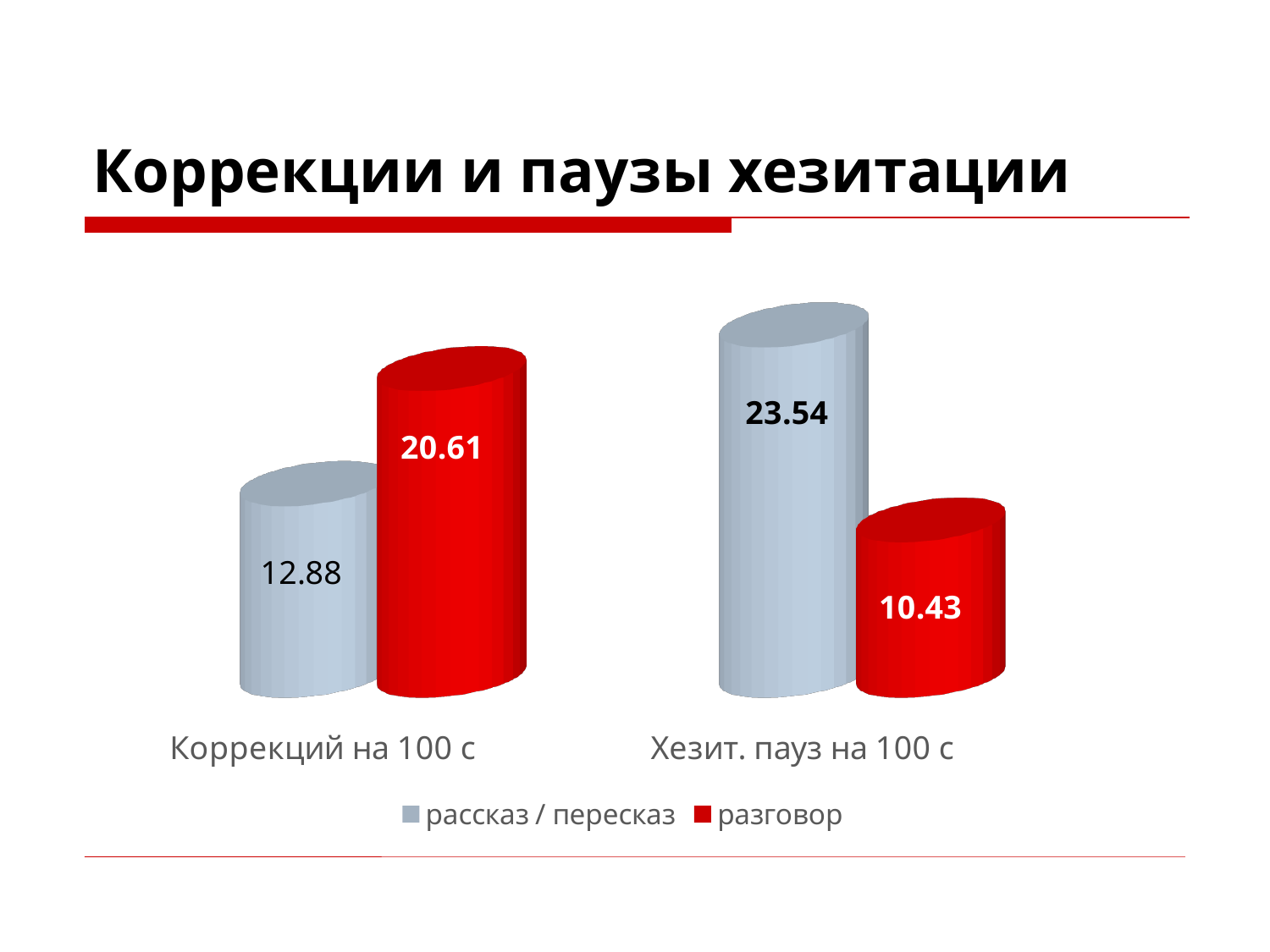
What is the difference between the рассказ / пересказ and разговор values in the Хезит. пауз на 100 с category? 13.11 Which bar has the highest value on the chart? рассказ / пересказ, Хезит. пауз на 100 с (23.54) What type of chart is shown on the slide? Bar chart How many series does the legend list? 2 What is the difference between the разговор and рассказ / пересказ values in the Коррекций на 100 с category? 7.73 What is the value for рассказ / пересказ in the Хезит. пауз на 100 с category? 23.54 Which bar has the lowest value on the chart? разговор, Хезит. пауз на 100 с (10.43) What is the value for разговор in the Коррекций на 100 с category? 20.61 Which series has the higher value in the Коррекций на 100 с category? разговор What is the value for рассказ / пересказ in the Коррекций на 100 с category? 12.88 Which series has the higher value in the Хезит. пауз на 100 с category? рассказ / пересказ What is the value for разговор in the Хезит. пауз на 100 с category? 10.43